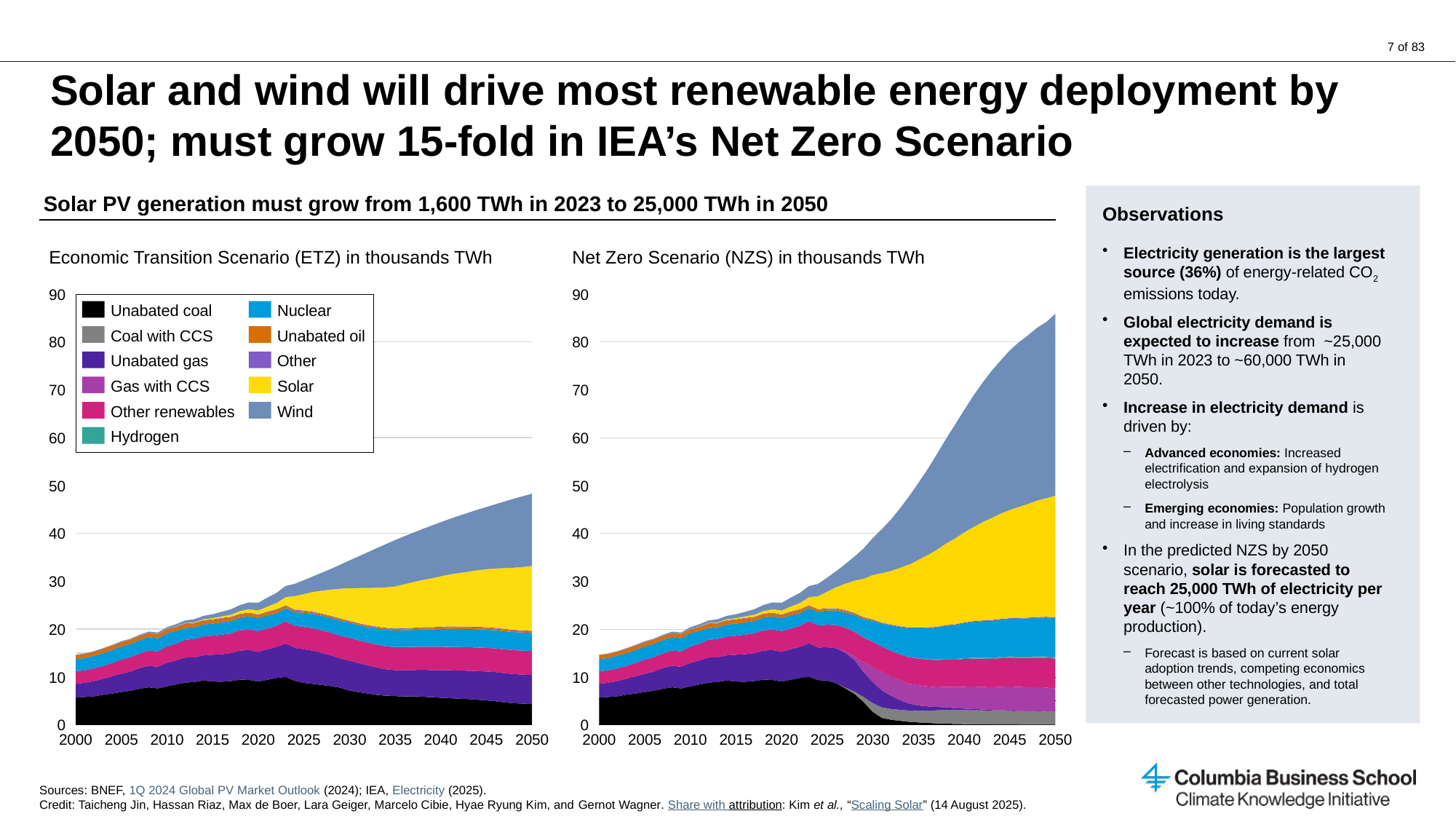
In the Net Zero Scenario (NZS) chart, does total generation rise or fall from 2000 to 2050? Rise How many series does the legend on the Economic Transition Scenario (ETZ) chart list? 11 In the Economic Transition Scenario (ETZ) chart, is the total generation in 2000 greater or less than 20? less What colour represents Solar in the legend of the Economic Transition Scenario (ETZ) chart? Yellow In the Net Zero Scenario (NZS) chart, is the total generation in 2050 greater or less than 80? greater In the Net Zero Scenario (NZS) chart, is the total generation in 2035 greater or less than 40? greater Which chart shows the larger total generation in 2050, the Economic Transition Scenario (ETZ) chart or the Net Zero Scenario (NZS) chart? Net Zero Scenario (NZS) In the Economic Transition Scenario (ETZ) chart, which series is shown at the top of the stack? Wind What kind of chart is the Economic Transition Scenario (ETZ) chart? Stacked area chart In the Economic Transition Scenario (ETZ) chart, does the Unabated coal area rise or fall from 2025 to 2050? Fall How many year labels are shown on the x axis of the Net Zero Scenario (NZS) chart? 11